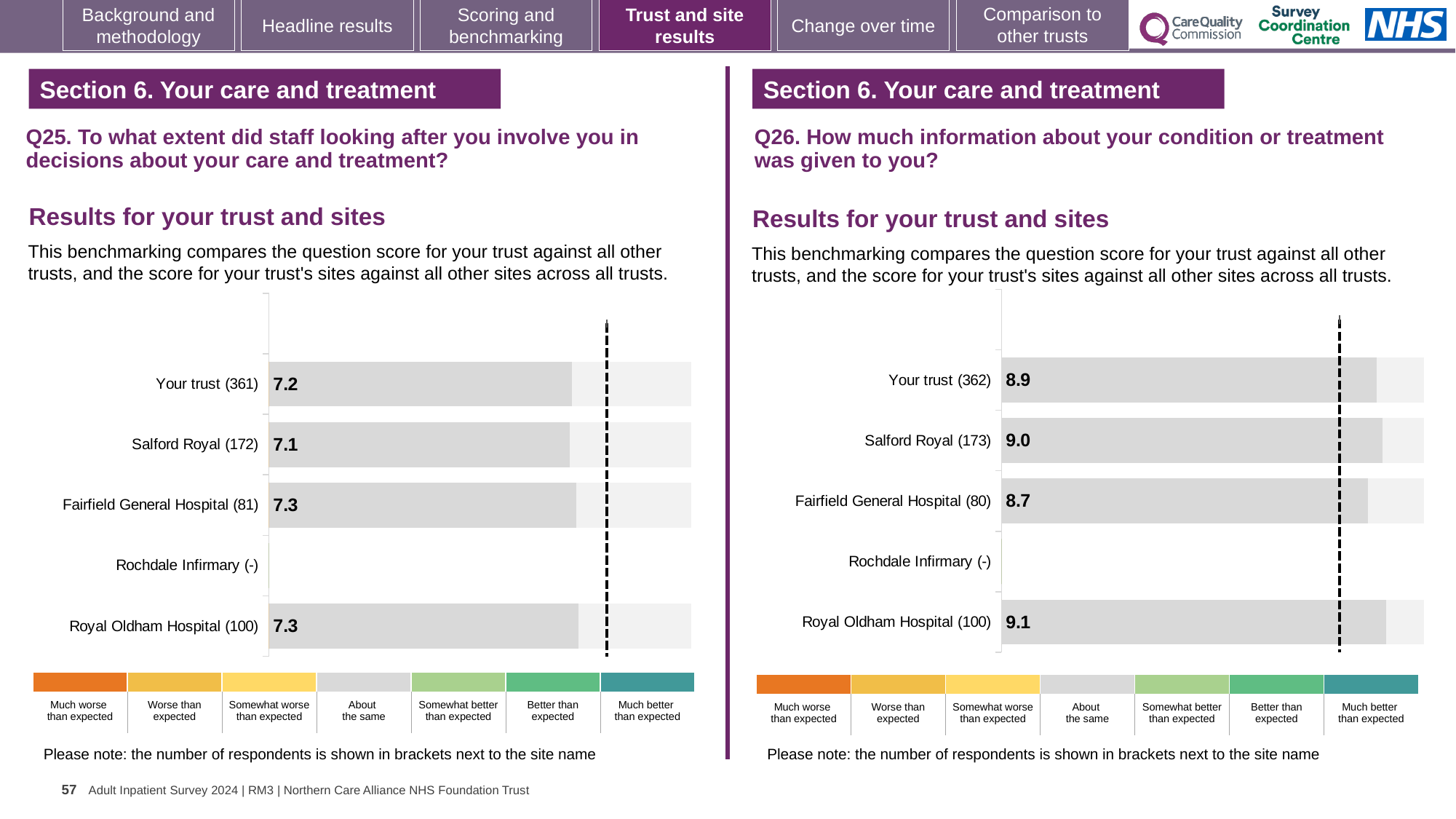
What type of chart is used for the Q25 results on the left? Bar chart In the Q25 chart on the left, what is the difference between the scores for Fairfield General Hospital and Salford Royal? 0.2 In the Q25 chart on the left, what is the score for Your trust? 7.2 In the Q25 chart on the left, what is the score for Salford Royal? 7.1 In the Q26 chart on the right, what is the score for Royal Oldham Hospital? 9.1 In the Q25 chart on the left, how many respondents are shown for Royal Oldham Hospital? 100 How many sites (including the trust) are listed in the Q26 chart on the right? 5 In the Q26 chart on the right, which has the higher score, Your trust or Salford Royal? Salford Royal In the Q25 chart on the left, which site has the lowest score? Salford Royal In the Q26 chart on the right, which site has the lowest score? Fairfield General Hospital In the Q26 chart on the right, which site has the highest score? Royal Oldham Hospital In the Q26 chart on the right, what is the difference between the scores for Royal Oldham Hospital and Fairfield General Hospital? 0.4